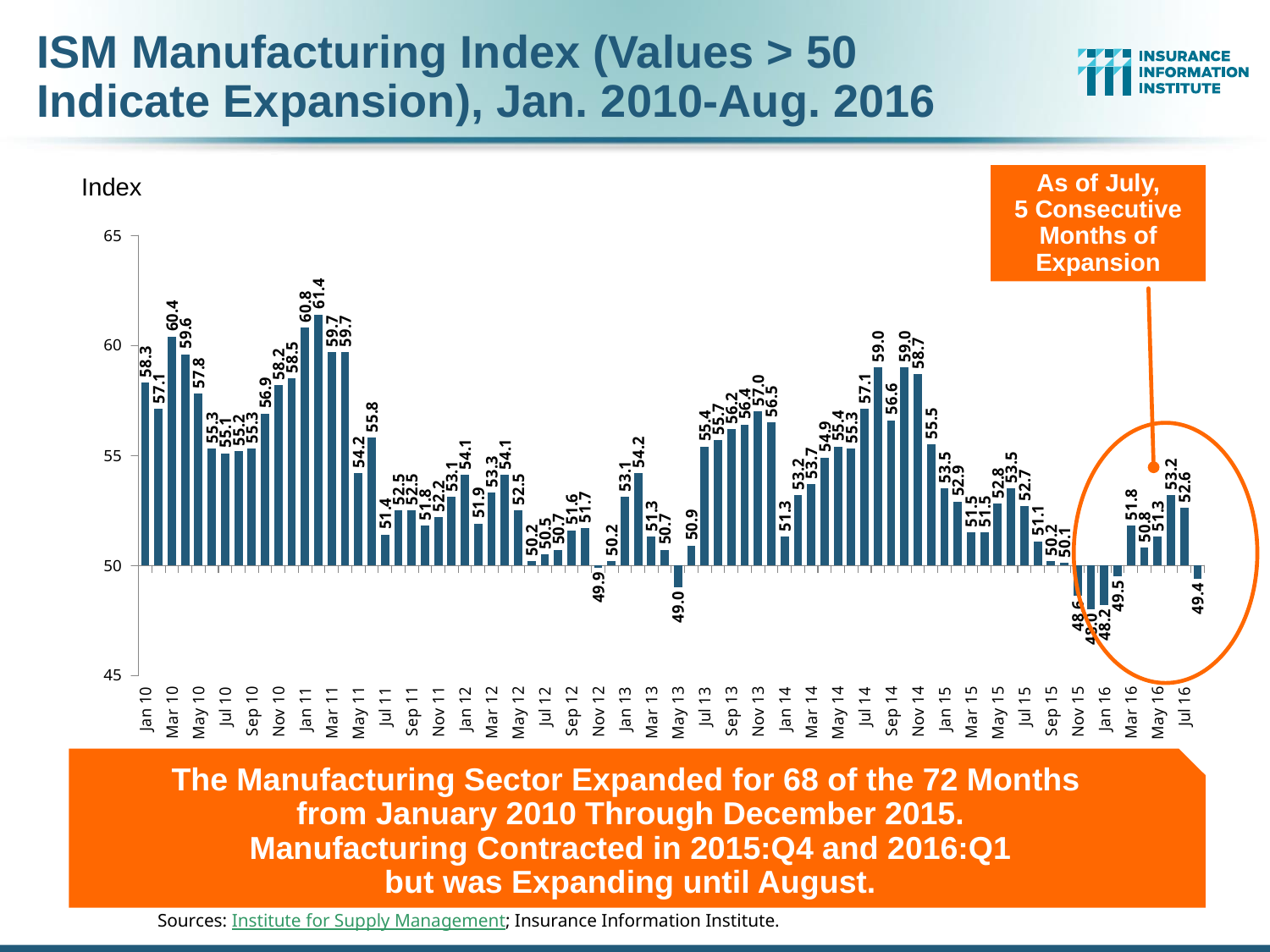
What is the highest ISM Manufacturing Index value shown on the chart? 61.4 What is the ISM Manufacturing Index value for Jan 10, the first bar on the chart? 58.3 What kind of chart is shown on the slide? Bar chart How many bars on the chart fall below the 50 line? 7 What label is shown on the vertical axis of the chart? Index Which is larger, the index value for Jan 10 or the value for the last bar (Aug 2016)? Jan 10 Is the value for the last bar on the chart (Aug 2016) greater or less than 50? less What is the ISM Manufacturing Index value for the last bar on the chart (Aug 2016)? 49.4 What is the difference between the Jun 16 value (53.2) and the Jul 16 value (52.6)? 0.6 What does the orange callout box above the circled bars say? As of July, 5 Consecutive Months of Expansion What is the ISM Manufacturing Index value for May 13? 49.0 What is the ISM Manufacturing Index value for Jul 16? 52.6